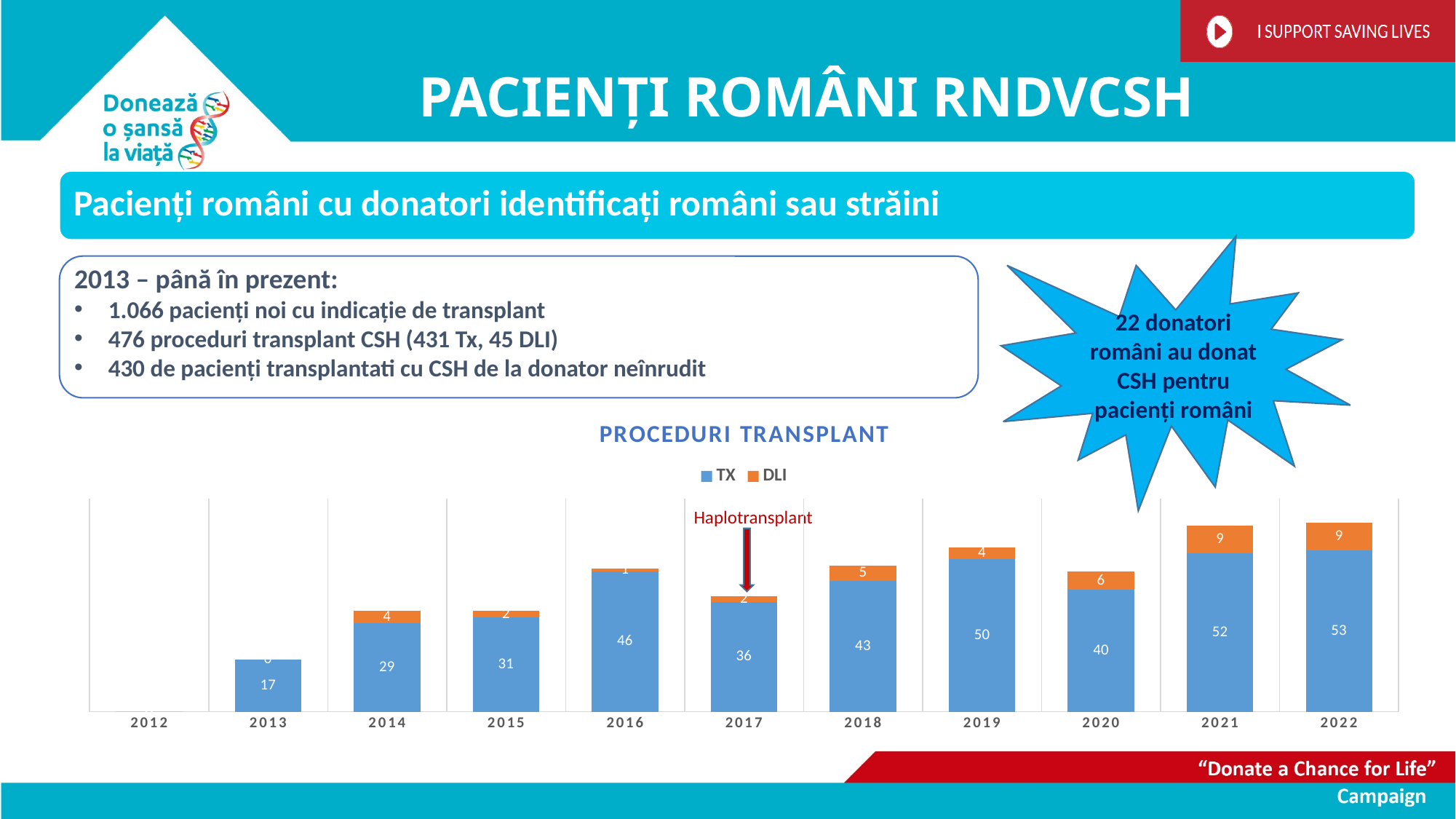
Which year has the highest TX value in the PROCEDURI TRANSPLANT chart? 2022 What type of chart is the PROCEDURI TRANSPLANT chart? Stacked bar chart What is the TX value for 2013 in the PROCEDURI TRANSPLANT chart? 17 What is the total of the stacked bar for 2021 in the PROCEDURI TRANSPLANT chart? 61 What is the TX value for 2022 in the PROCEDURI TRANSPLANT chart? 53 Which is larger in the PROCEDURI TRANSPLANT chart: the TX value for 2016 or the TX value for 2017? 2016 What is the total of the stacked bar for 2018 in the PROCEDURI TRANSPLANT chart? 48 What is the DLI value for 2020 in the PROCEDURI TRANSPLANT chart? 6 What is the difference between the TX values for 2019 and 2020 in the PROCEDURI TRANSPLANT chart? 10 Which year with a plotted bar has the lowest TX value in the PROCEDURI TRANSPLANT chart? 2013 How many series does the legend of the PROCEDURI TRANSPLANT chart list? 2 How many year categories are shown on the x axis of the PROCEDURI TRANSPLANT chart? 11